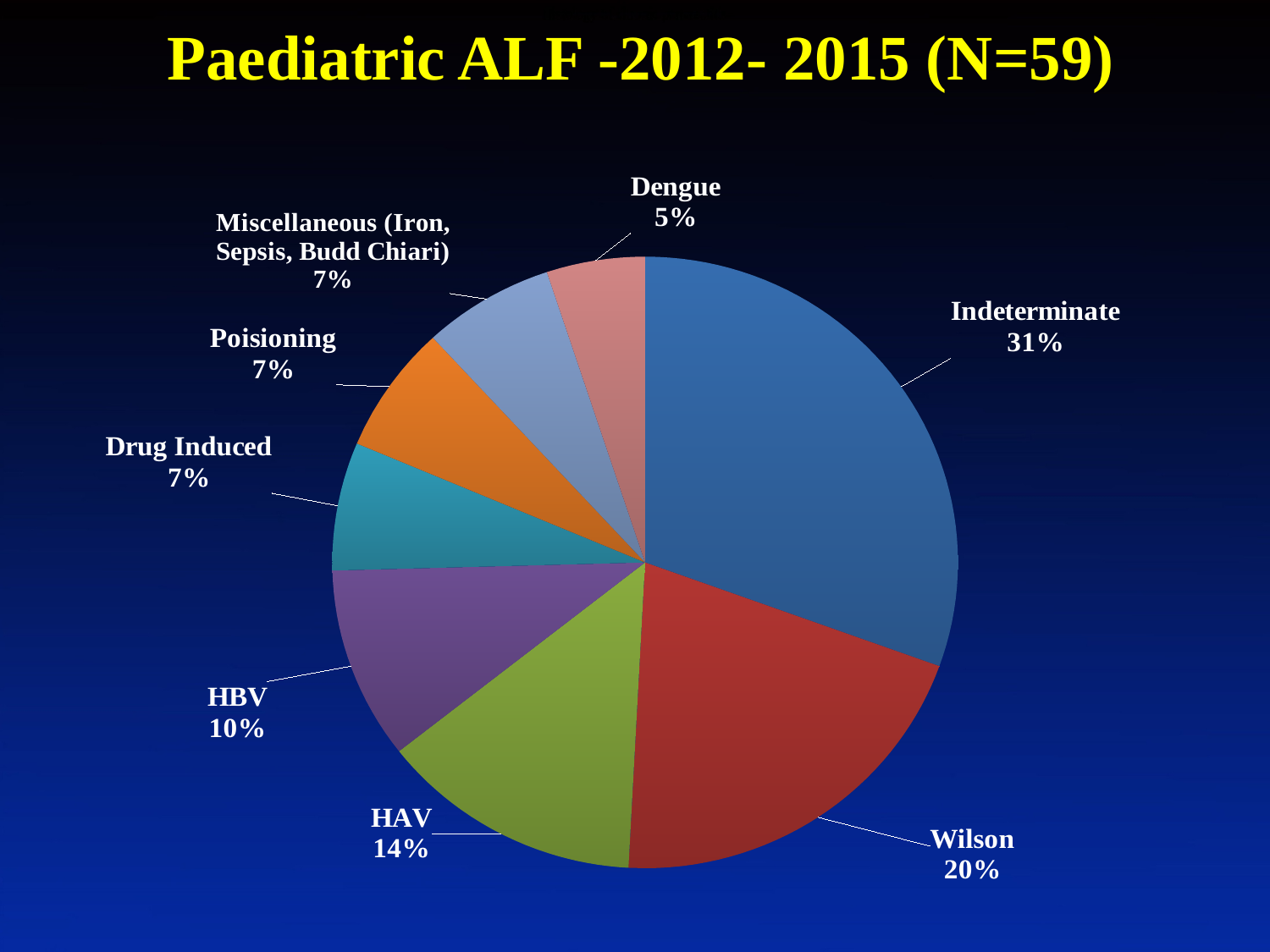
What percentage is shown for HAV? 14% What type of chart is shown on the slide? pie chart What percentage is shown for HBV? 10% Which category has the smallest slice of the pie? Dengue Which is larger, the share for HAV or the share for HBV? HAV What share of the pie does Indeterminate account for? 31% What is the difference in percentage points between Indeterminate and Wilson? 11 How many categories are shown in the pie chart? 8 What is the title of the chart? Paediatric ALF -2012- 2015 (N=59) What percentage is shown for Dengue? 5% Which category has the largest slice of the pie? Indeterminate What percentage is shown for Wilson? 20%